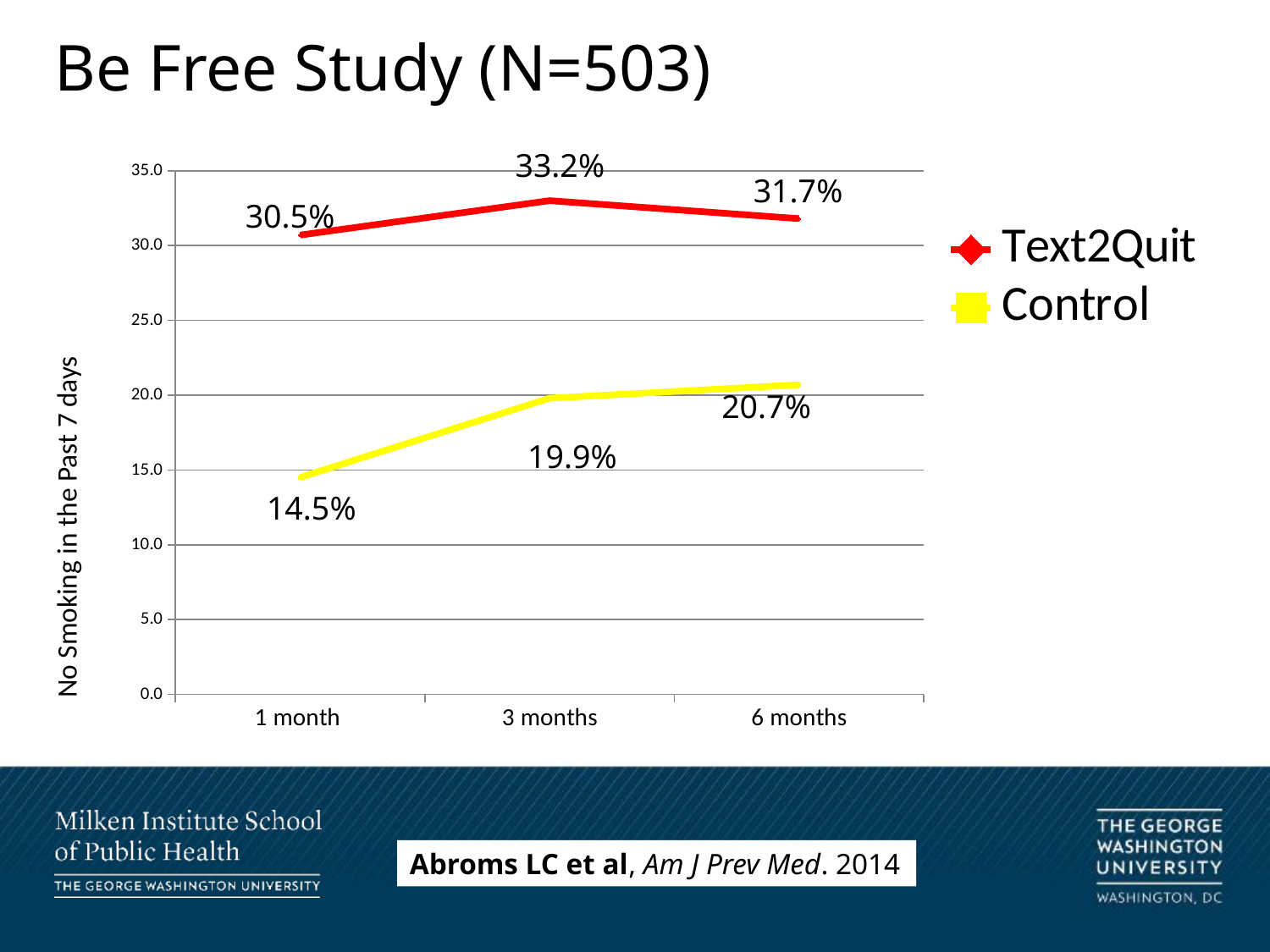
What is the Control value at 1 month? 14.5% What is the Text2Quit value at 3 months? 33.2% Which series has the larger value at 6 months, Text2Quit or Control? Text2Quit Does the Control series rise or fall from 1 month to 6 months? Rise At which time point is the Text2Quit value highest? 3 months At which time point is the Control value lowest? 1 month What kind of chart is shown on the slide? Line chart What is the Text2Quit value at 6 months? 31.7% What is the difference between the Text2Quit and Control values at 1 month? 16.0% How many time points are shown on the x axis? 3 What is the Control value at 6 months? 20.7% How many series does the legend list? 2